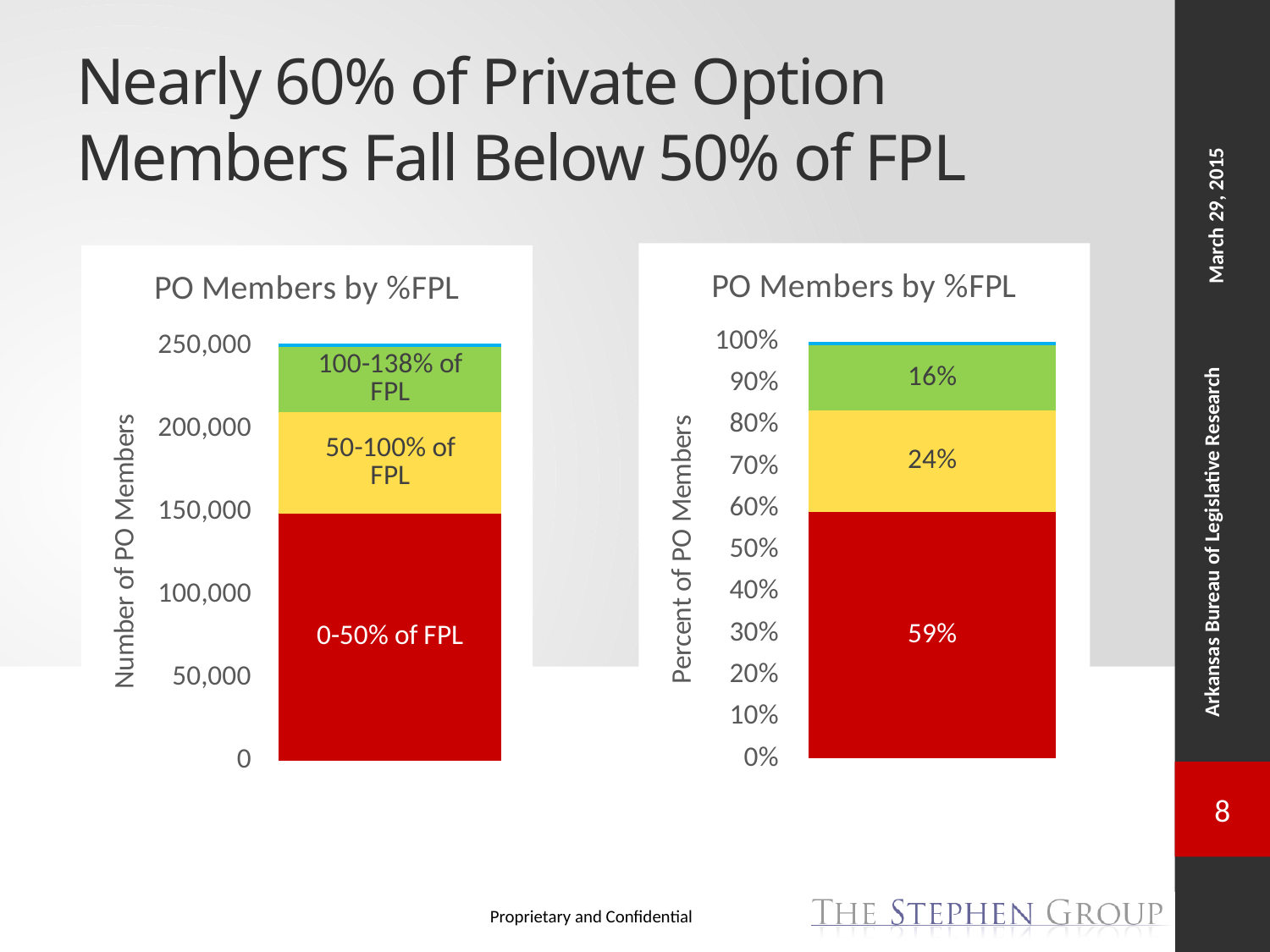
In the right chart, which segment has the largest share of PO members? The red segment, 59% In the right chart, what is the difference between the red segment's percentage and the yellow segment's percentage? 35% In the left chart, is the number of PO members in the 0-50% of FPL segment greater or less than 100,000? greater In the right chart (PO Members by %FPL, percent), what percentage of PO members is shown for the bottom red segment? 59% In the right chart, what percentage is shown for the yellow middle segment? 24% In the right chart, what percentage is shown for the green top segment? 16% In the left chart, does the top of the 50-100% of FPL segment reach above or below 200,000 on the axis? above What kind of chart is the left chart? Stacked bar chart In the right chart, what is the combined percentage of the yellow and green segments? 40% How many FPL ranges are labeled on the left chart's bar? 3 What is the y-axis title of the left chart? Number of PO Members In the right chart, which is larger: the yellow segment (24%) or the green segment (16%)? The yellow segment (24%)